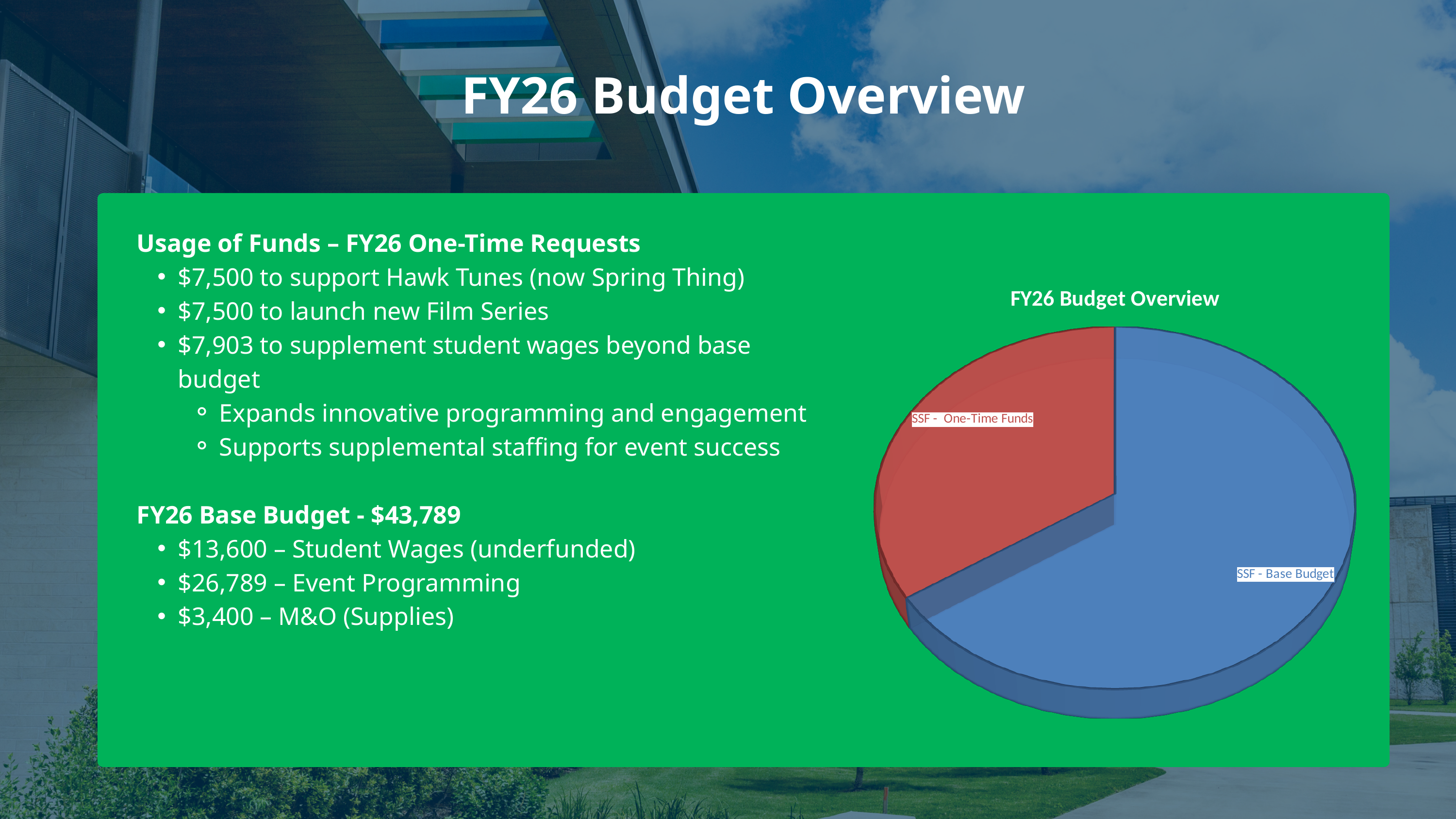
Which slice of the pie chart is the smallest? SSF - One-Time Funds Which slice of the pie chart is the largest? SSF - Base Budget What is the title of the pie chart? FY26 Budget Overview What kind of chart is shown on the slide? Pie chart How many slices does the pie chart have? 2 Does the SSF - Base Budget slice take up more or less than half of the pie chart? More In the pie chart, which is larger: SSF - Base Budget or SSF - One-Time Funds? SSF - Base Budget What colour is the SSF - One-Time Funds slice in the pie chart? Red